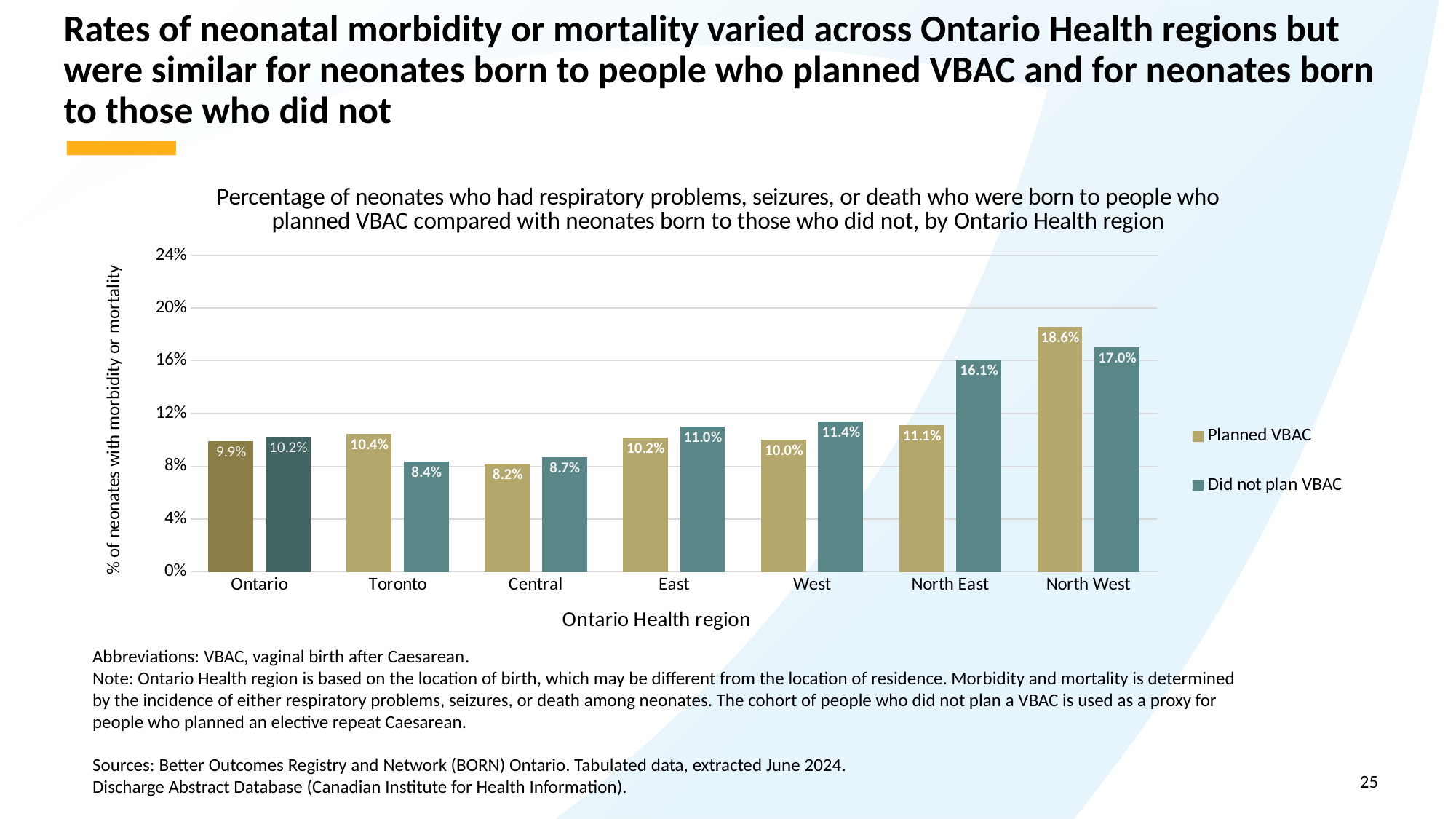
Which region has the highest Did not plan VBAC value? North West How many series does the legend list? 2 What is the difference between the Did not plan VBAC and Planned VBAC values for North East? 5.0% What is the Planned VBAC value for Ontario? 9.9% What kind of chart is shown on the slide? Bar chart What is the label of the x axis? Ontario Health region Is the Did not plan VBAC value for North East greater or less than 12%? greater Which region has the lowest Planned VBAC value? Central How many regions are shown on the x axis? 7 What is the Planned VBAC value for North West? 18.6% What is the Did not plan VBAC value for Toronto? 8.4% Which is larger for Toronto: the Planned VBAC value or the Did not plan VBAC value? Planned VBAC